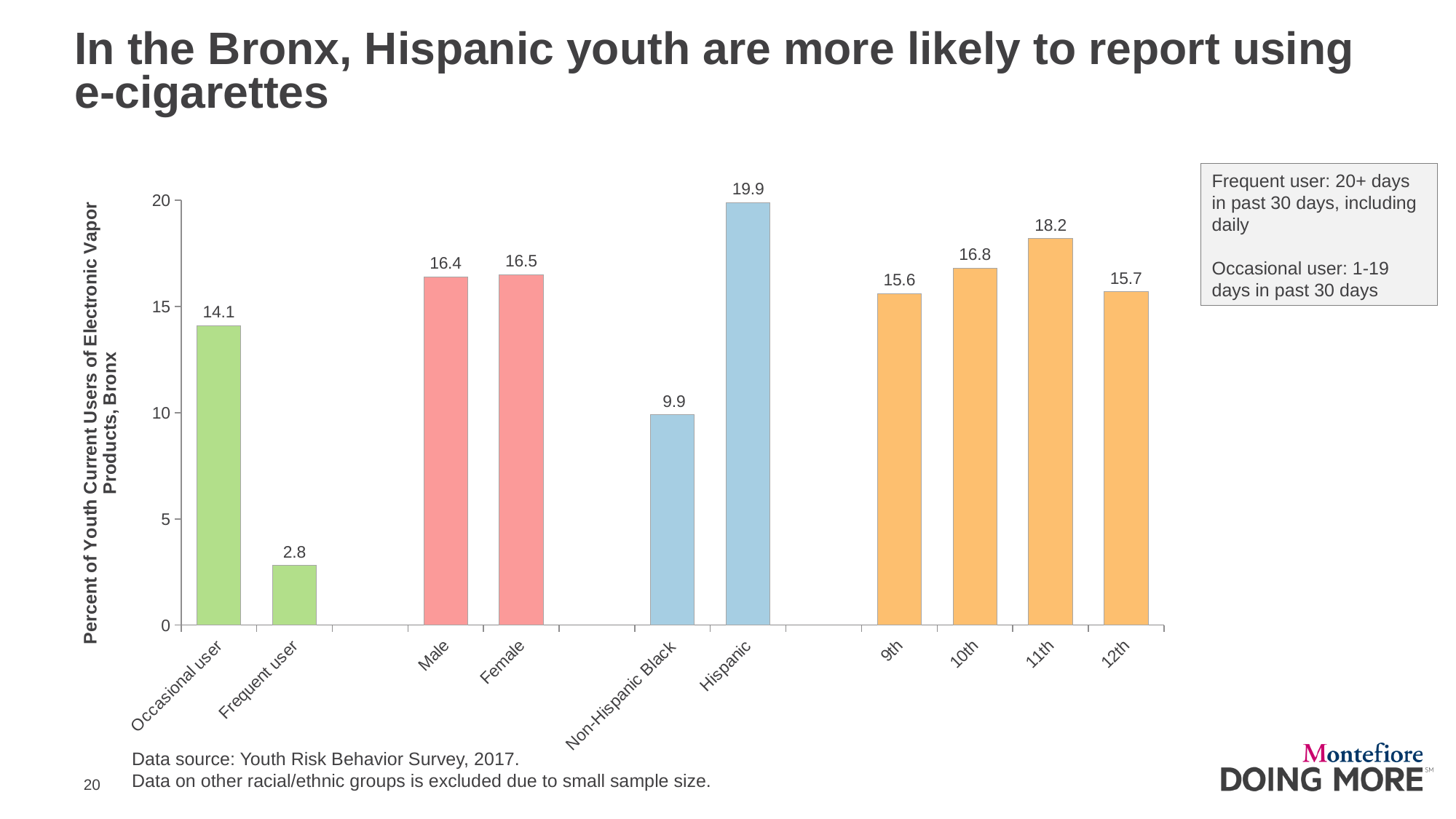
What is the value for Hispanic youth? 19.9 How many bars are plotted on the chart? 10 Is the value for Non-Hispanic Black greater or less than 10? less What kind of chart is shown? bar chart What is the value for 11th grade? 18.2 What is the difference between the values for Hispanic and Non-Hispanic Black? 10.0 Which category has the highest value? Hispanic Which category has the lowest value? Frequent user What is the value for Frequent user? 2.8 Which is larger, the value for 10th grade or 12th grade? 10th What is the difference between the values for Occasional user and Frequent user? 11.3 What is the y-axis label of the chart? Percent of Youth Current Users of Electronic Vapor Products, Bronx